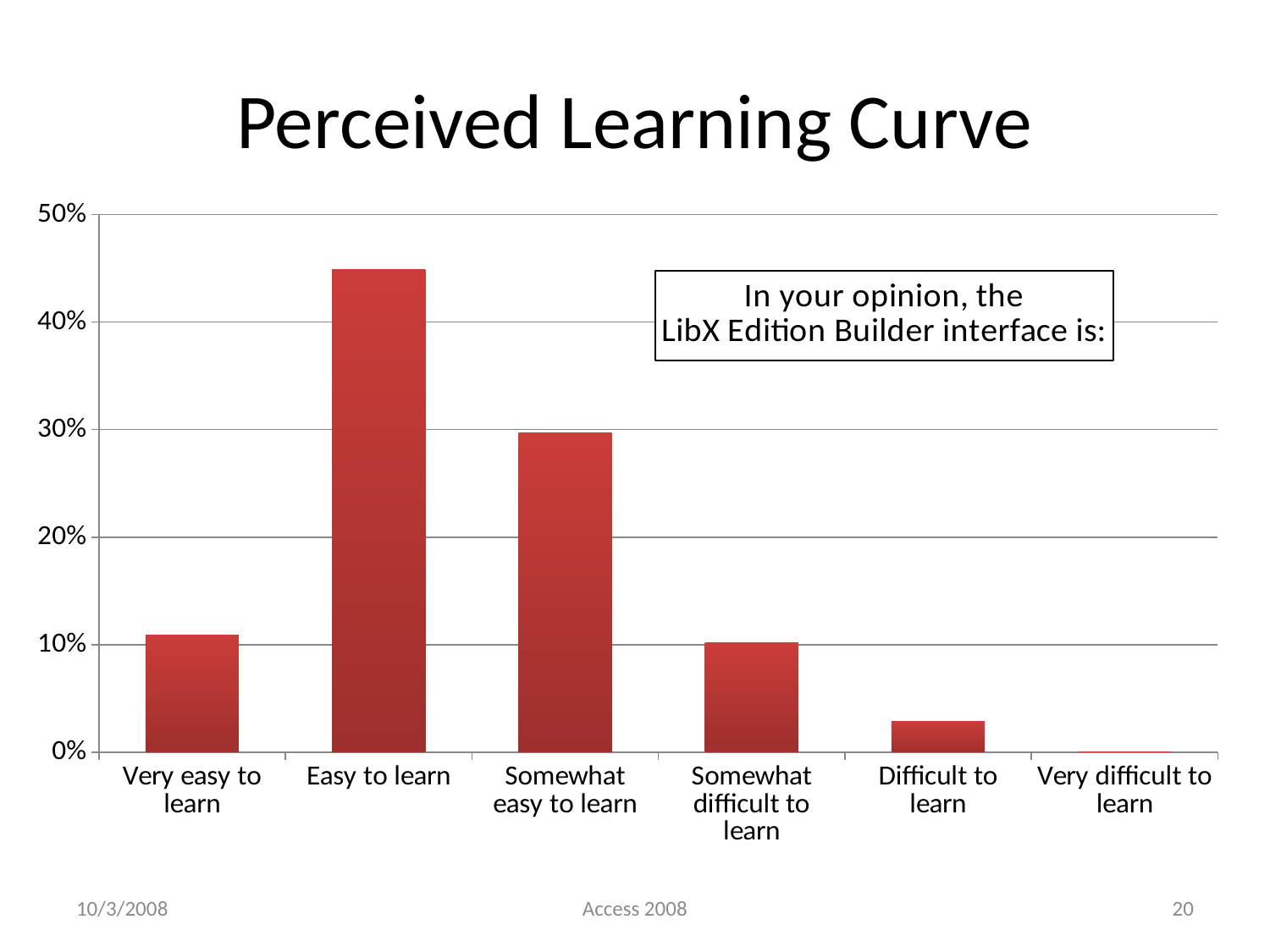
Which is larger, the value for Somewhat difficult to learn or the value for Difficult to learn? Somewhat difficult to learn What is the title of the chart? Perceived Learning Curve Is the value for Easy to learn greater or less than 40%? greater What type of chart is shown on the slide? bar chart Is the value for Somewhat easy to learn greater or less than 20%? greater Which category has the highest value? Easy to learn Is the value for Easy to learn greater or less than 50%? less Which category has the lowest value? Very difficult to learn From Easy to learn through Very difficult to learn, do the values rise or fall along the x axis? fall Which is larger, the value for Easy to learn or the value for Somewhat easy to learn? Easy to learn How many categories are shown on the x axis? 6